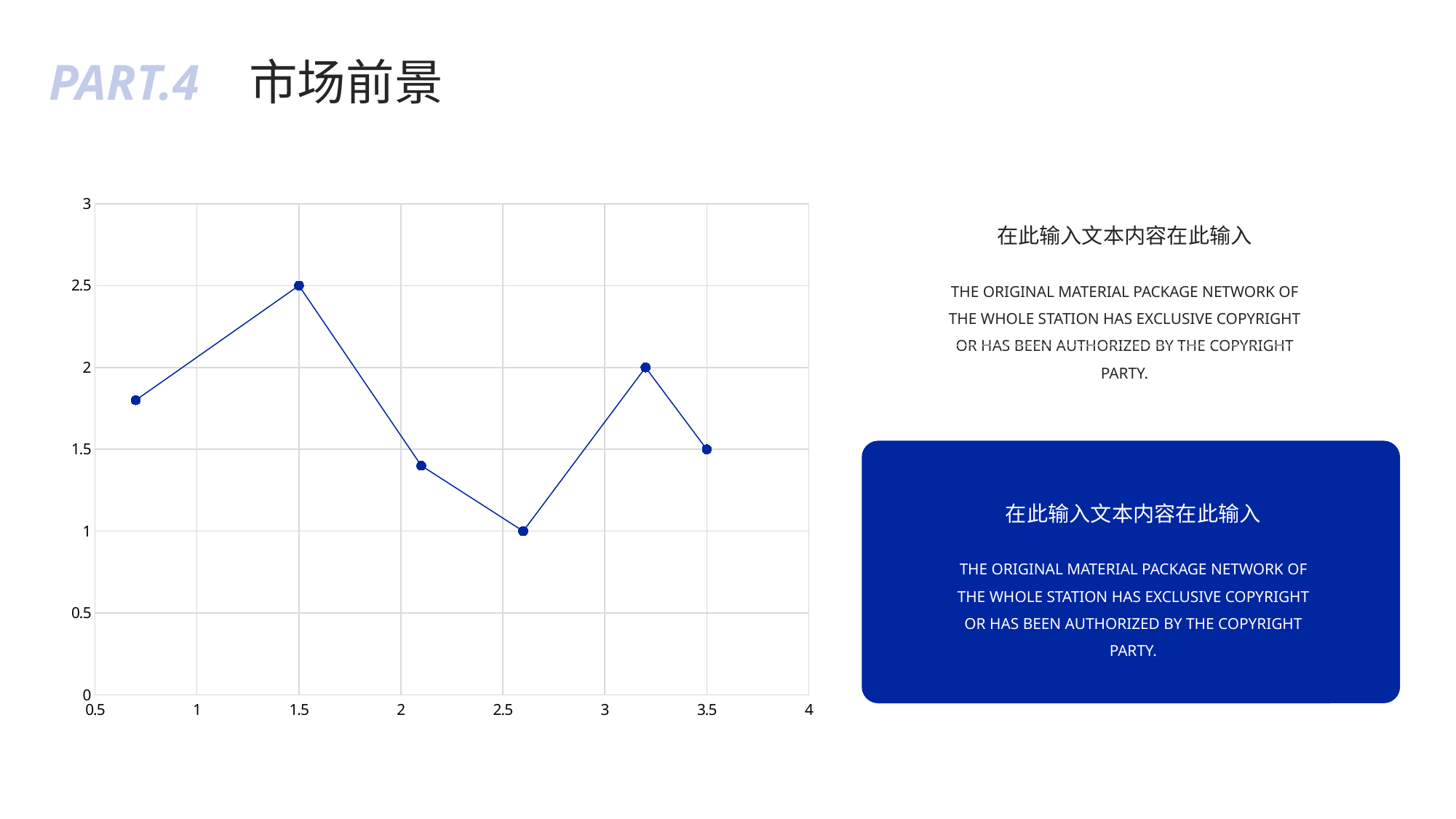
How many data points are plotted on the chart? 6 What is the y value of the lowest point on the chart? 1 What is the y value of the point at x = 3.5? 1.5 Is the y value of the third point from the left greater or less than 2? less Do the values rise steadily from left to right along the x axis? No, they rise and fall Is the y value of the first (leftmost) point greater or less than 1.5? greater What type of chart is shown on the slide? line chart What is the difference between the y value at x = 1.5 and the y value at x = 3.5? 1 At which x value does the chart reach its highest point? 1.5 Which point is the lowest on the chart, counting from the left? the fourth point What is the y value of the point at x = 1.5? 2.5 Which is larger, the y value at x = 1.5 or the y value at x = 3.5? x = 1.5